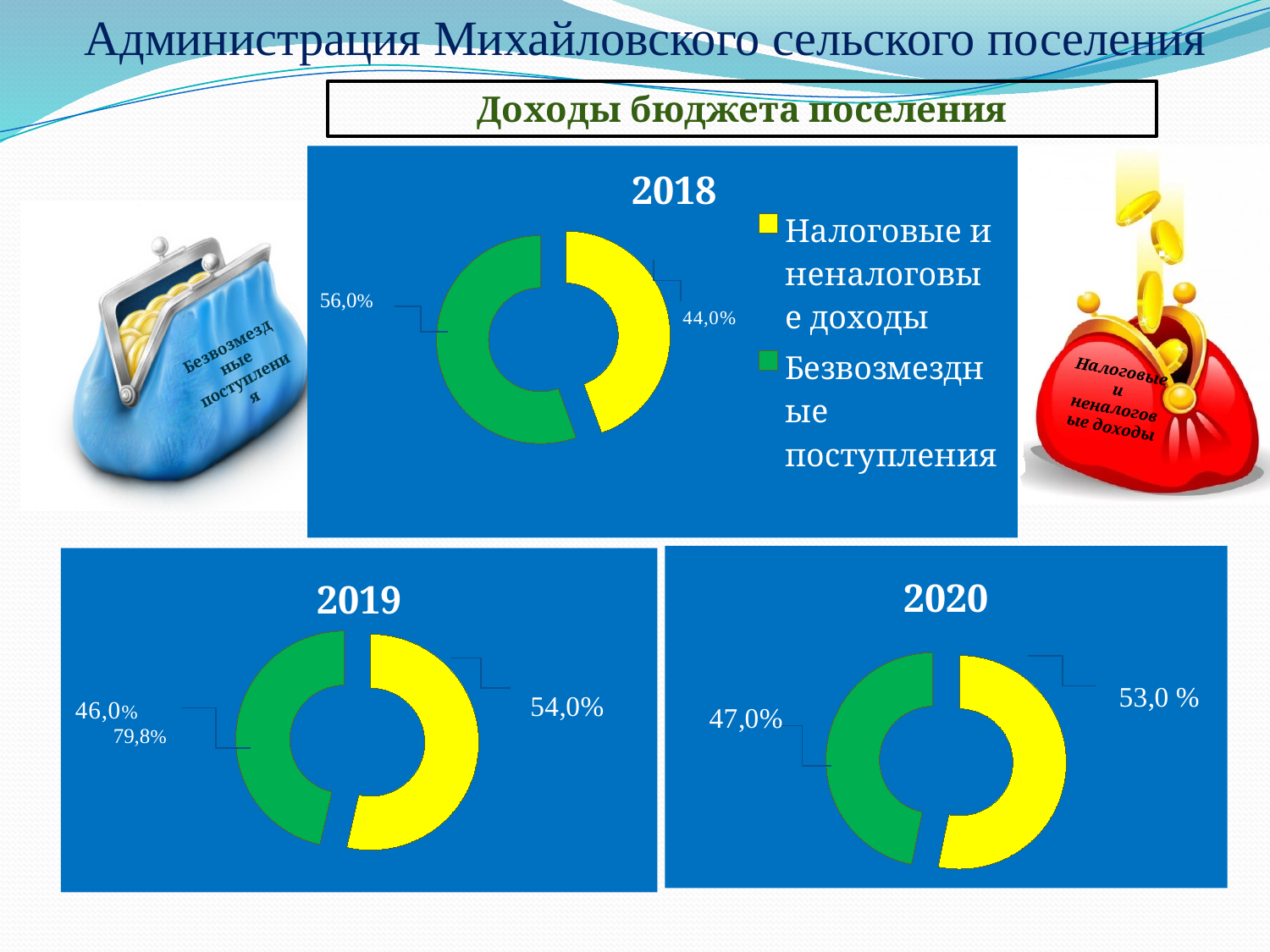
In the 2020 chart, what value is shown for the yellow segment (Налоговые и неналоговые доходы)? 53,0 % In the 2019 chart, what value is shown for the green segment (Безвозмездные поступления)? 46,0% In the 2020 chart, what value is shown for the green segment (Безвозмездные поступления)? 47,0% In the 2019 chart, what value is shown for the yellow segment (Налоговые и неналоговые доходы)? 54,0% In the 2020 chart, which category has the smaller share? Безвозмездные поступления In the 2018 chart, what is the share of Безвозмездные поступления? 56,0% In the 2018 chart, what is the share of Налоговые и неналоговые доходы? 44,0% In the 2019 chart, is the share of Налоговые и неналоговые доходы larger or smaller than the share of Безвозмездные поступления? larger In the 2018 chart, which category has the larger share? Безвозмездные поступления In the 2018 chart, what is the difference between the shares of Безвозмездные поступления and Налоговые и неналоговые доходы? 12,0% What type of chart is used for the 2018 data? Doughnut chart How many categories does the legend of the 2018 chart list? 2